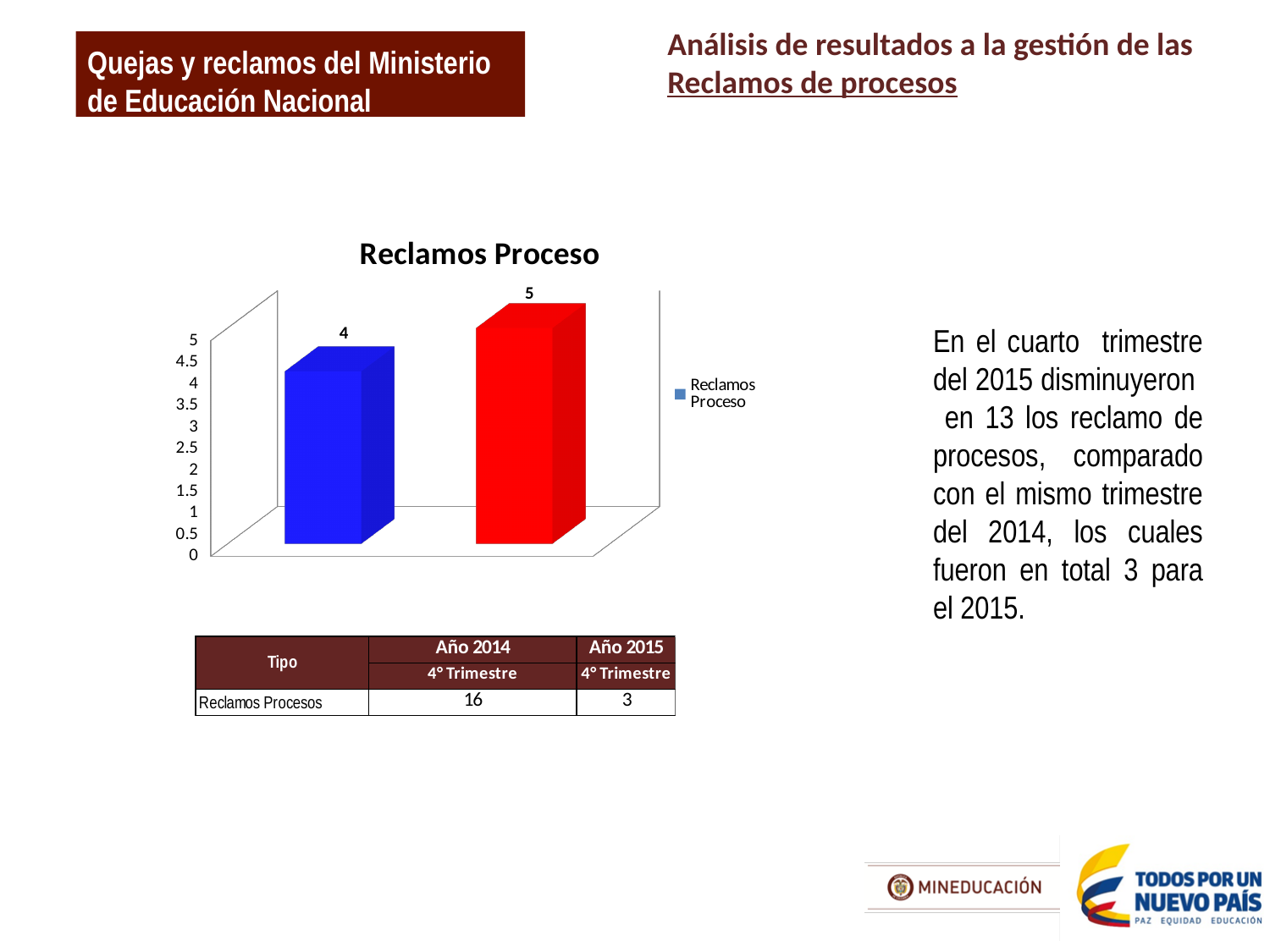
Is the value of the red bar in the Reclamos Proceso chart greater or less than 4.5? greater Which bar is taller in the Reclamos Proceso chart, the blue one or the red one? the red one What is the value shown on the blue bar in the Reclamos Proceso chart? 4 How many series does the legend of the Reclamos Proceso chart list? 1 What is the difference between the red bar and the blue bar in the Reclamos Proceso chart? 1 Is the value of the blue bar in the Reclamos Proceso chart greater or less than 3? greater How many bars are plotted in the Reclamos Proceso chart? 2 Which bar has the lowest value in the Reclamos Proceso chart? the blue bar What is the title of the chart? Reclamos Proceso What type of chart is shown on the slide? bar chart What is the value shown on the red bar in the Reclamos Proceso chart? 5 What is the name of the series listed in the legend of the chart? Reclamos Proceso